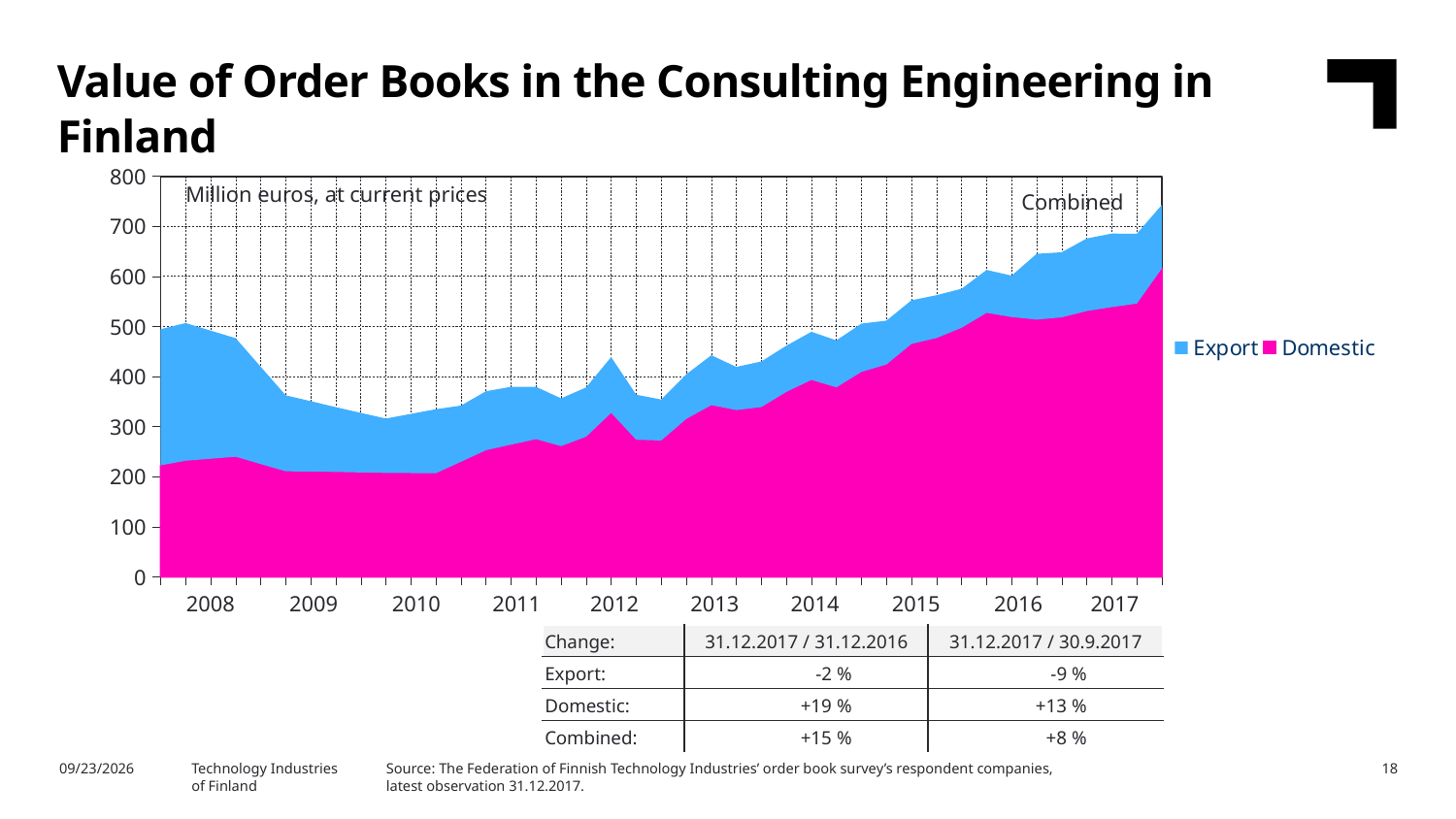
Is the combined value of order books at the end of 2017 greater or less than 700? greater How many series does the chart legend list? 2 Is the Domestic value in 2010 greater or less than 300? less According to the table below the chart, what is the change in the Domestic order book from 31.12.2016 to 31.12.2017? +19 % Which two series are listed in the chart legend? Export and Domestic Does the combined value of order books rise or fall between 2013 and 2017? rise How many years are labelled on the x axis of the chart? 10 In what unit are the values on the chart expressed? Million euros, at current prices Is the Domestic value at the end of 2017 greater or less than 500? greater What type of chart is shown on the slide? Stacked area chart At the end of 2017, which is larger, the Domestic or the Export value? Domestic